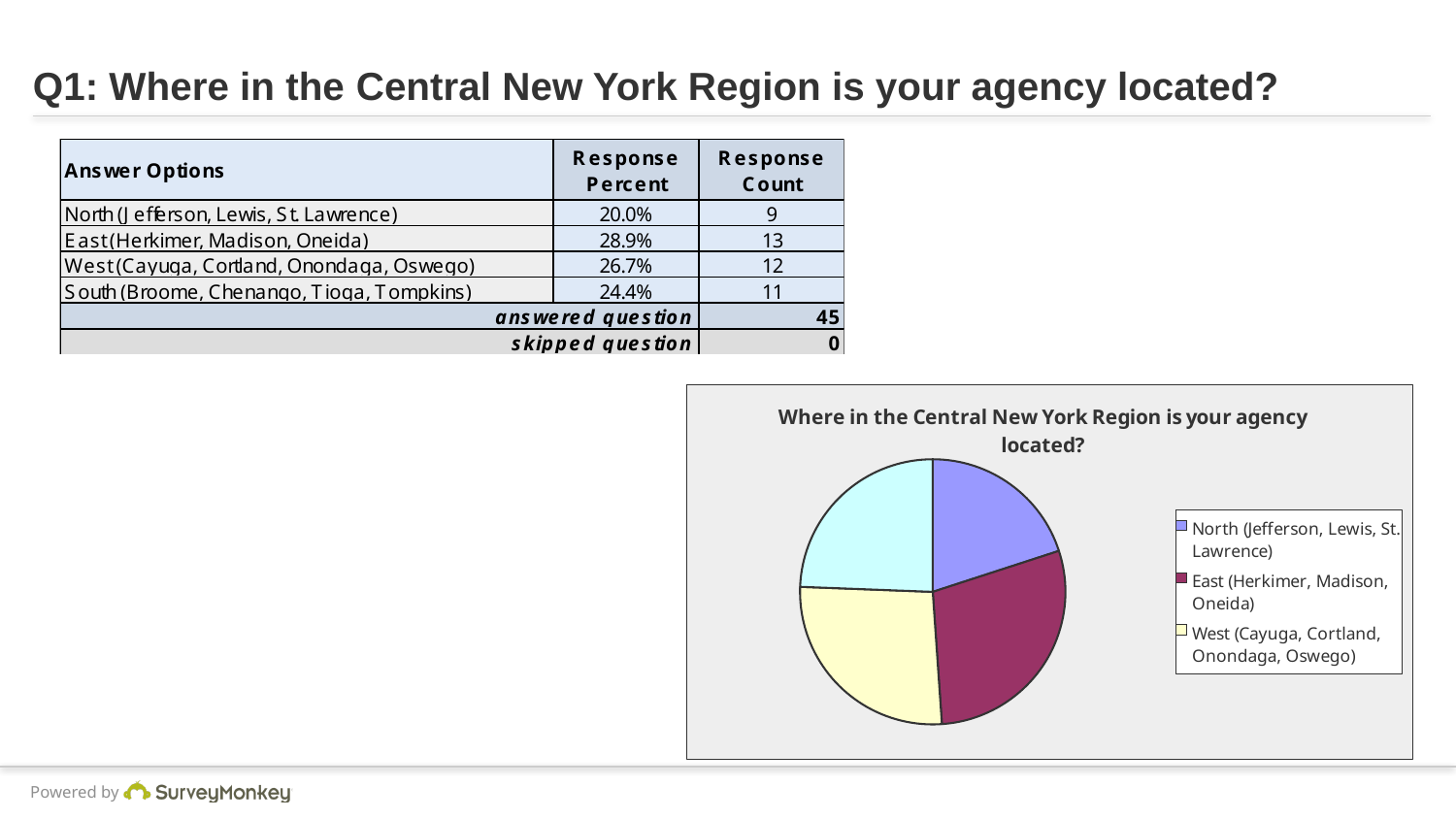
Which has a larger response count, West or South? West (Cayuga, Cortland, Onondaga, Oswego) What response percent is shown for East (Herkimer, Madison, Oneida)? 28.9% What kind of chart is shown on the slide? pie chart What response count is shown for West (Cayuga, Cortland, Onondaga, Oswego)? 12 Which region has the largest share of responses? East (Herkimer, Madison, Oneida) What colour is the slice for East (Herkimer, Madison, Oneida) in the pie chart? maroon Which region has the smallest share of responses? North (Jefferson, Lewis, St. Lawrence) What is the difference in response count between East and North? 4 How many slices does the pie chart have? 4 How many entries does the pie chart's legend list? 3 What is the title of the pie chart? Where in the Central New York Region is your agency located? What response percent is shown for North (Jefferson, Lewis, St. Lawrence)? 20.0%